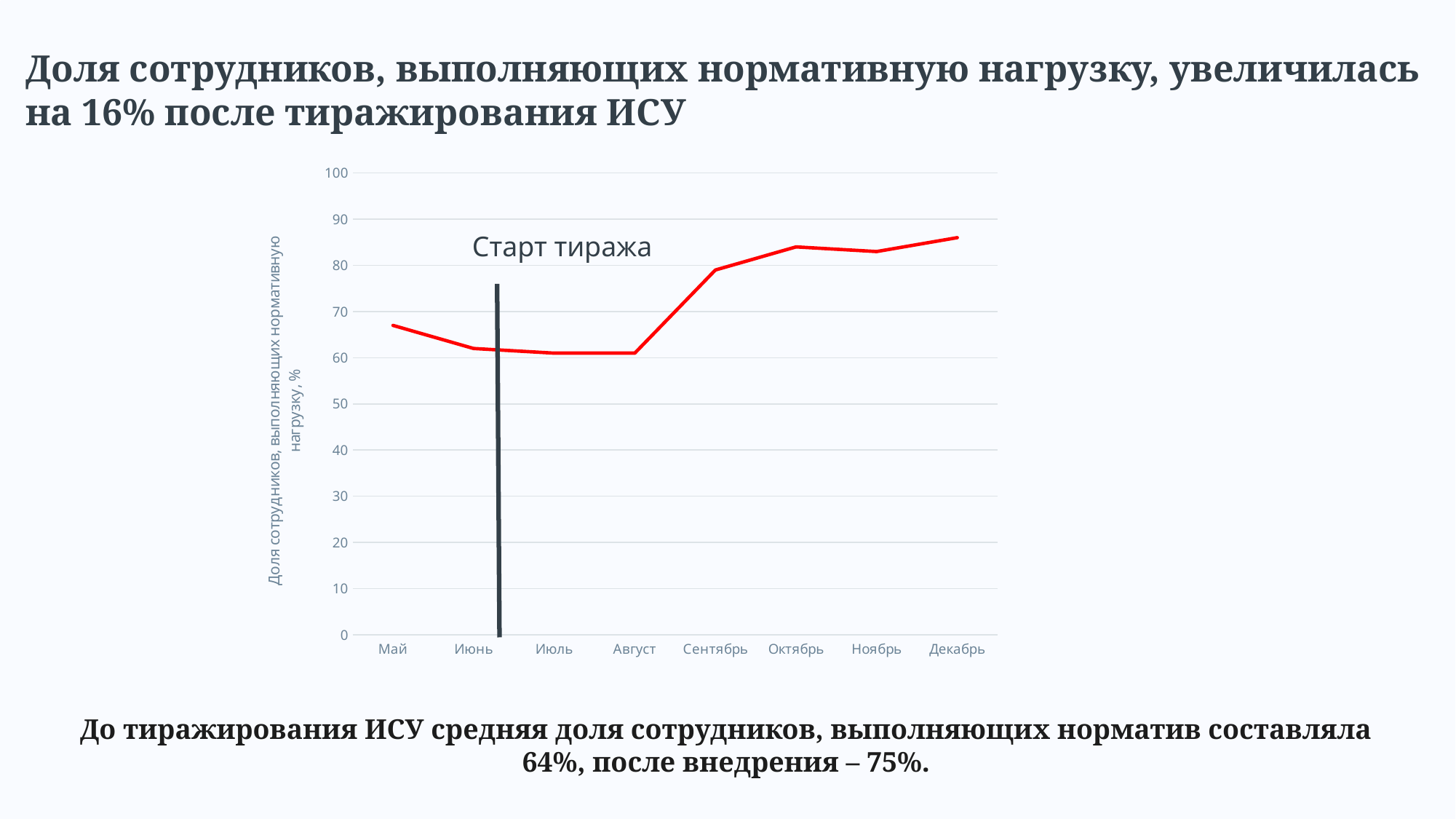
Is the value for Август (August) greater or less than 70? less How many months are plotted along the x axis of the chart? 8 What label is written next to the vertical line on the chart? Старт тиража Is the value for Сентябрь (September) greater or less than 70? greater Is the value for Декабрь (December) greater or less than 80? greater Which is larger, the value for Май (May) or the value for Сентябрь (September)? Сентябрь What kind of chart is shown on the slide? line chart Do the values rise or fall from Август (August) to Декабрь (December)? rise Which is larger, the value for Июль (July) or the value for Октябрь (October)? Октябрь What colour is the plotted line on the chart? red